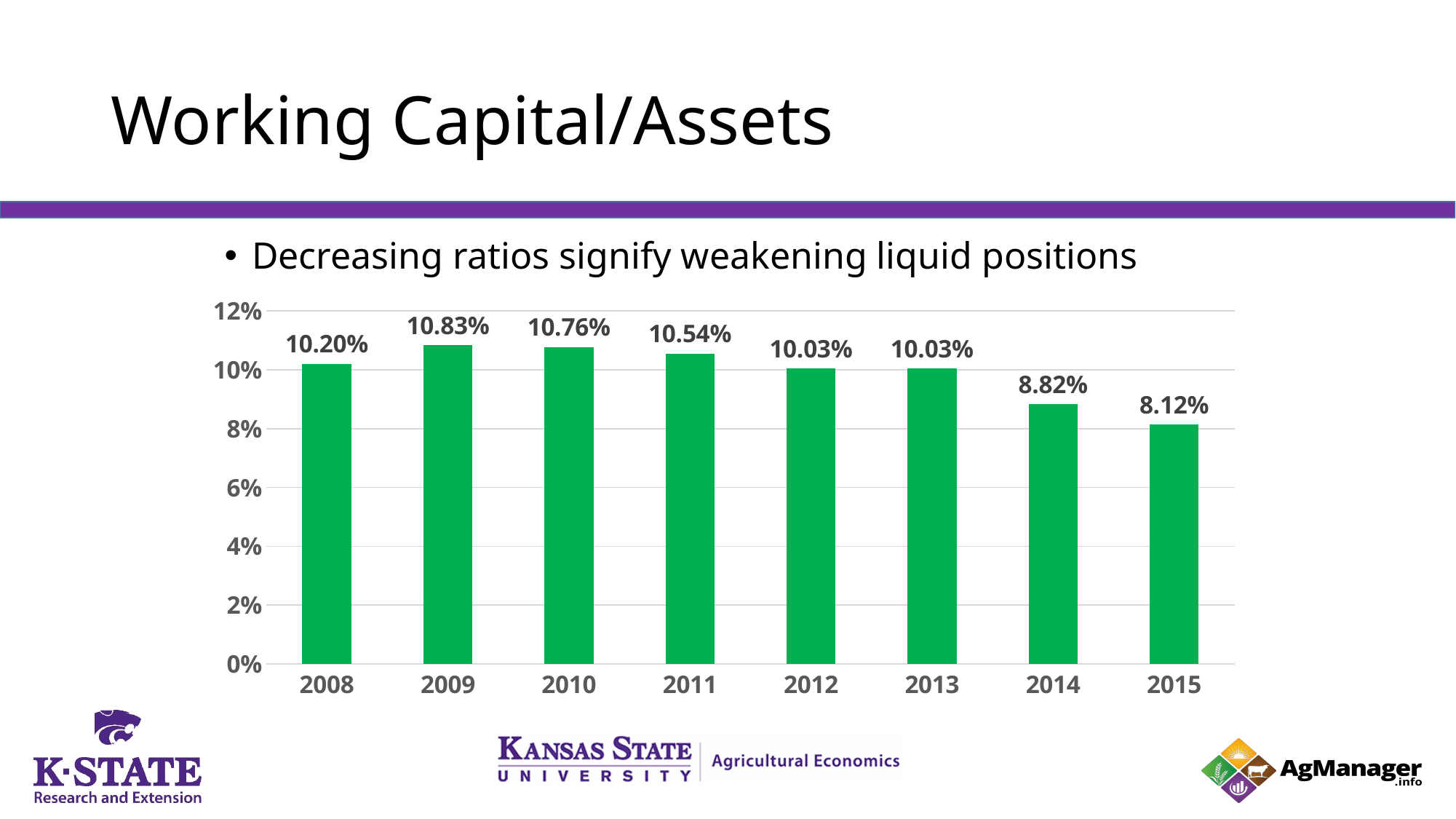
What is the Working Capital/Assets value for 2009? 10.83% Do the values generally rise or fall from 2009 to 2015? fall Is the value for 2014 greater or less than 10%? less What is the value shown for 2011? 10.54% What is the difference between the 2014 value and the 2015 value? 0.70% How many years are shown on the x axis? 8 What kind of chart is shown on the slide? bar chart What is the difference between the 2009 value and the 2015 value? 2.71% Which year has the highest Working Capital/Assets ratio? 2009 What is the Working Capital/Assets value for 2015? 8.12% Which year has a larger value, 2008 or 2014? 2008 Which year has the lowest Working Capital/Assets ratio? 2015